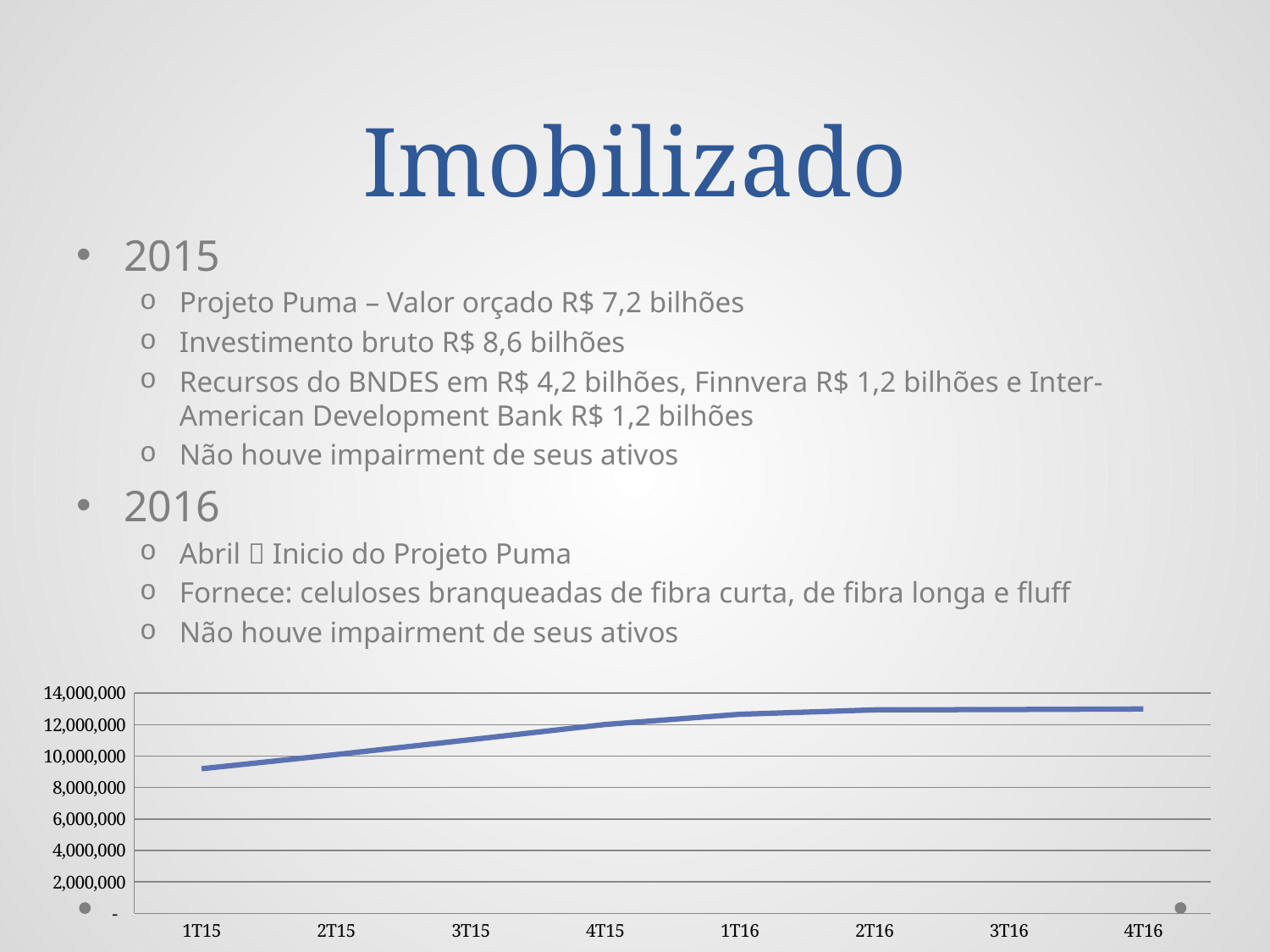
Do the values in the chart rise or fall from 1T15 to 4T16? rise Is the value for 4T15 greater or less than 14,000,000? less What kind of chart is shown at the bottom of the slide? line chart How many quarters are plotted along the x axis of the chart? 8 Which is larger, the value for 1T15 or the value for 4T16? 4T16 What is the highest value shown on the y axis of the chart? 14,000,000 Is the value for 3T15 greater or less than 10,000,000? greater Is the value for 1T15 greater or less than 10,000,000? less Which is larger, the value for 2T15 or the value for 1T16? 1T16 Which quarter has the lowest value in the chart? 1T15